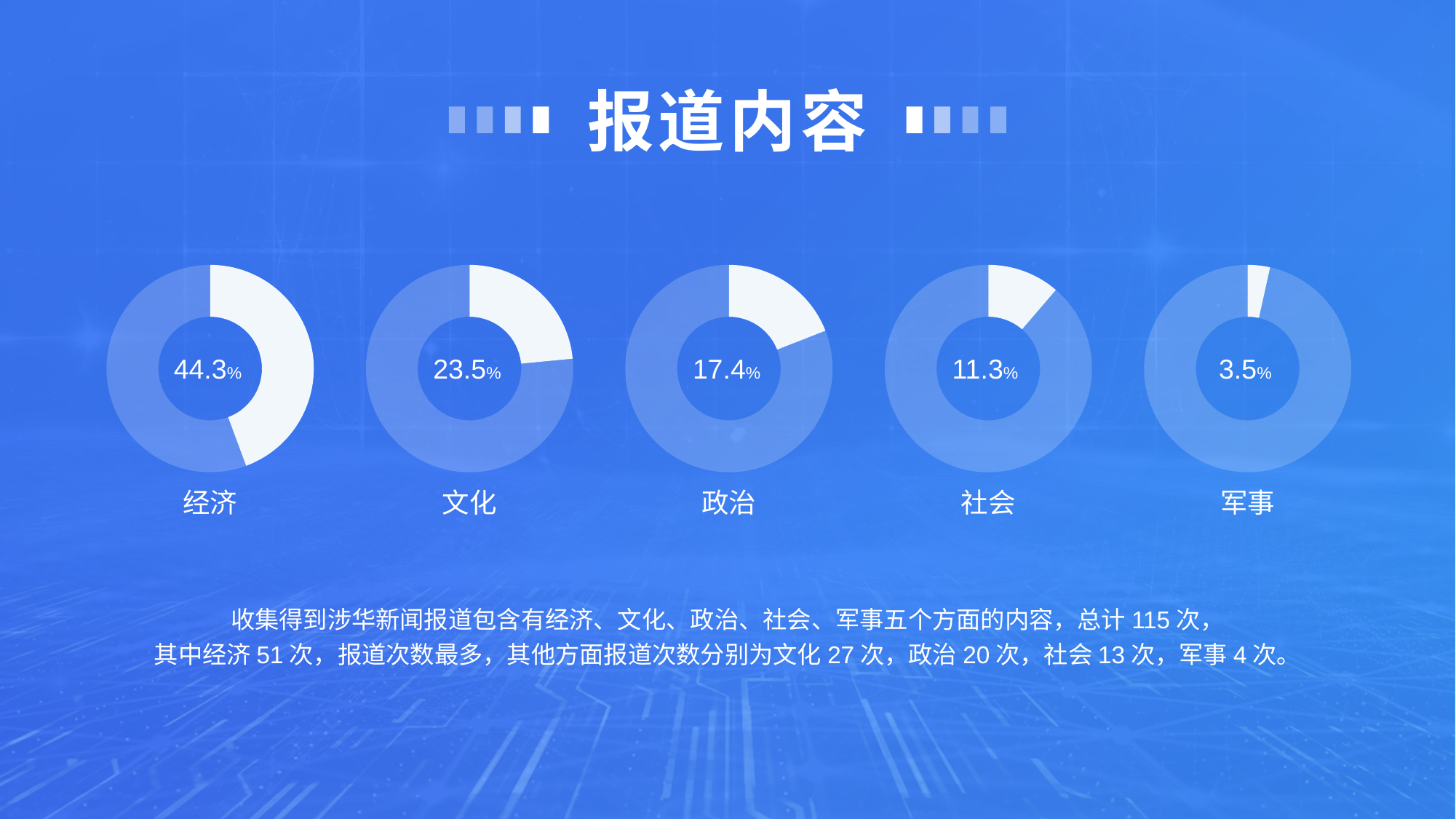
What percentage is shown in the 政治 donut chart? 17.4% What percentage is shown in the 社会 donut chart? 11.3% Among the five donut charts, which category has the lowest percentage? 军事 What is the difference between the percentages shown in the 经济 and 文化 donut charts? 20.8% Which has a larger percentage, the 政治 donut chart or the 社会 donut chart? 政治 How many donut charts are shown on the slide? 5 What percentage is shown in the 军事 donut chart? 3.5% What is the title of the slide containing the donut charts? 报道内容 What percentage is shown in the 经济 donut chart? 44.3% What kind of chart is used to show each category's percentage on the slide? Donut chart Among the five donut charts, which category has the highest percentage? 经济 What percentage is shown in the 文化 donut chart? 23.5%